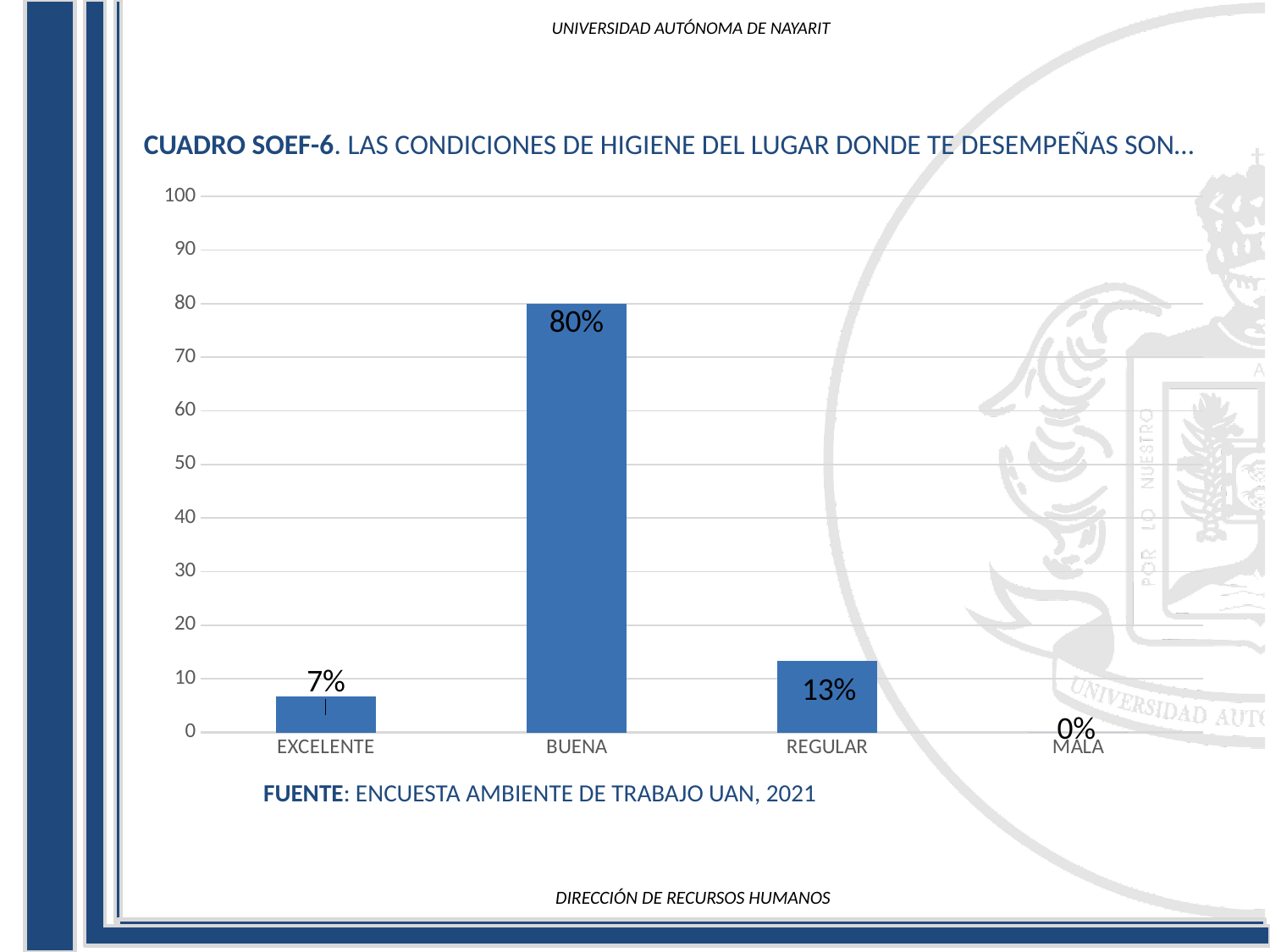
What is the value for EXCELENTE? 7% Which category has the lowest value? MALA What is the value for MALA? 0% What is the value for REGULAR? 13% What kind of chart is shown on the slide? bar chart What is the value for BUENA? 80% Which is larger, the value for REGULAR or the value for EXCELENTE? REGULAR What source is cited below the chart? ENCUESTA AMBIENTE DE TRABAJO UAN, 2021 Is the value for BUENA greater or less than 50? greater What is the difference between the values for BUENA and REGULAR? 67% How many categories are shown on the x axis? 4 Which category has the highest value? BUENA